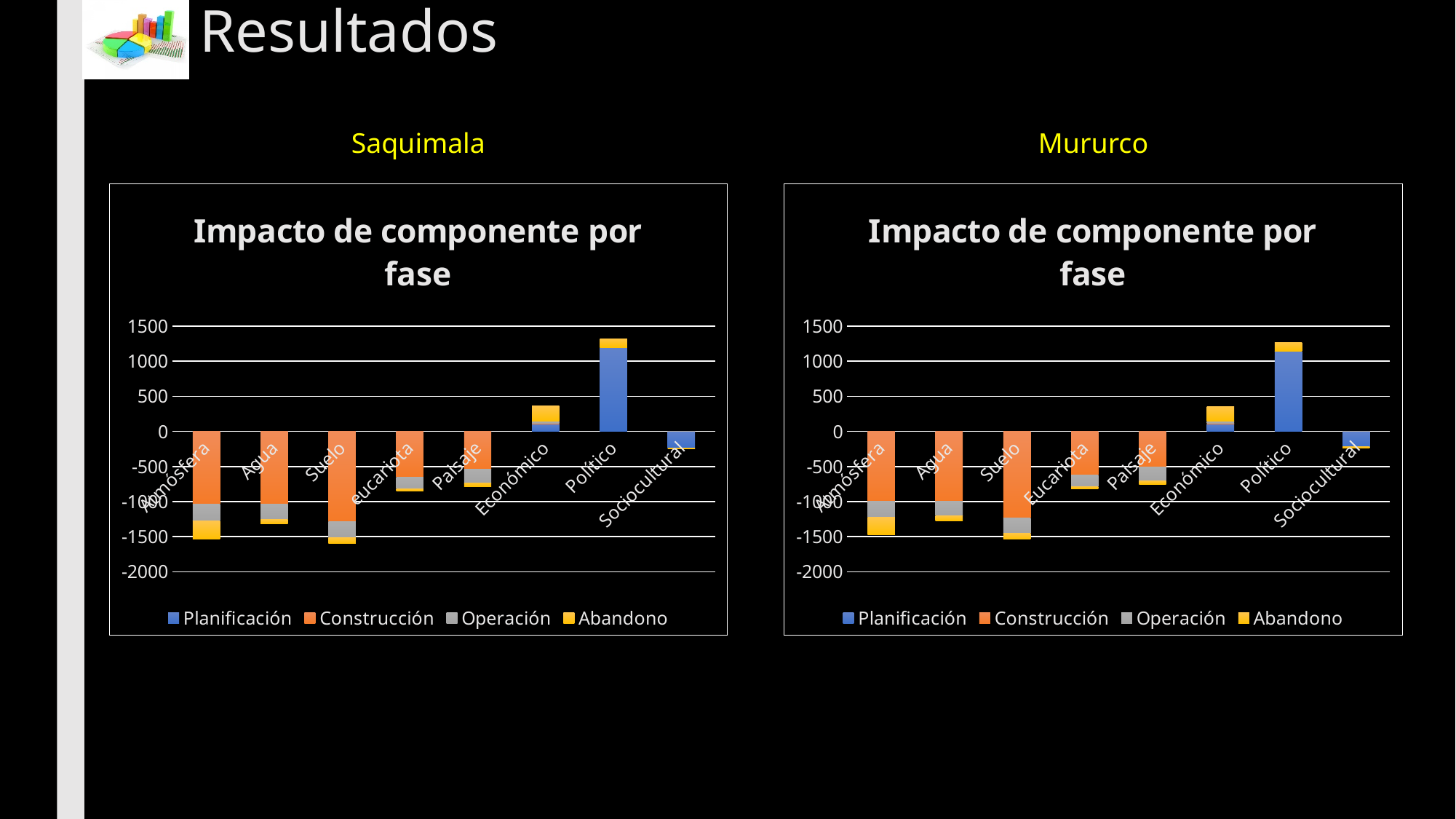
How many series does the legend of the Mururco chart list? 4 In the Saquimala chart, is the stacked total for Político greater or less than 1000? greater In the Mururco chart, is the stacked total for Político greater or less than 1000? greater In the Mururco chart, is the stacked total for Sociocultural greater or less than -500? greater How many categories are shown on the x axis of the Saquimala chart? 8 In the Saquimala chart, which category has the highest stacked total? Político What is the title of the Mururco chart? Impacto de componente por fase In the Mururco chart, which category has the highest stacked total? Político In the Saquimala chart, which has the larger stacked total, Político or Económico? Político What kind of chart is the Saquimala chart? stacked bar chart